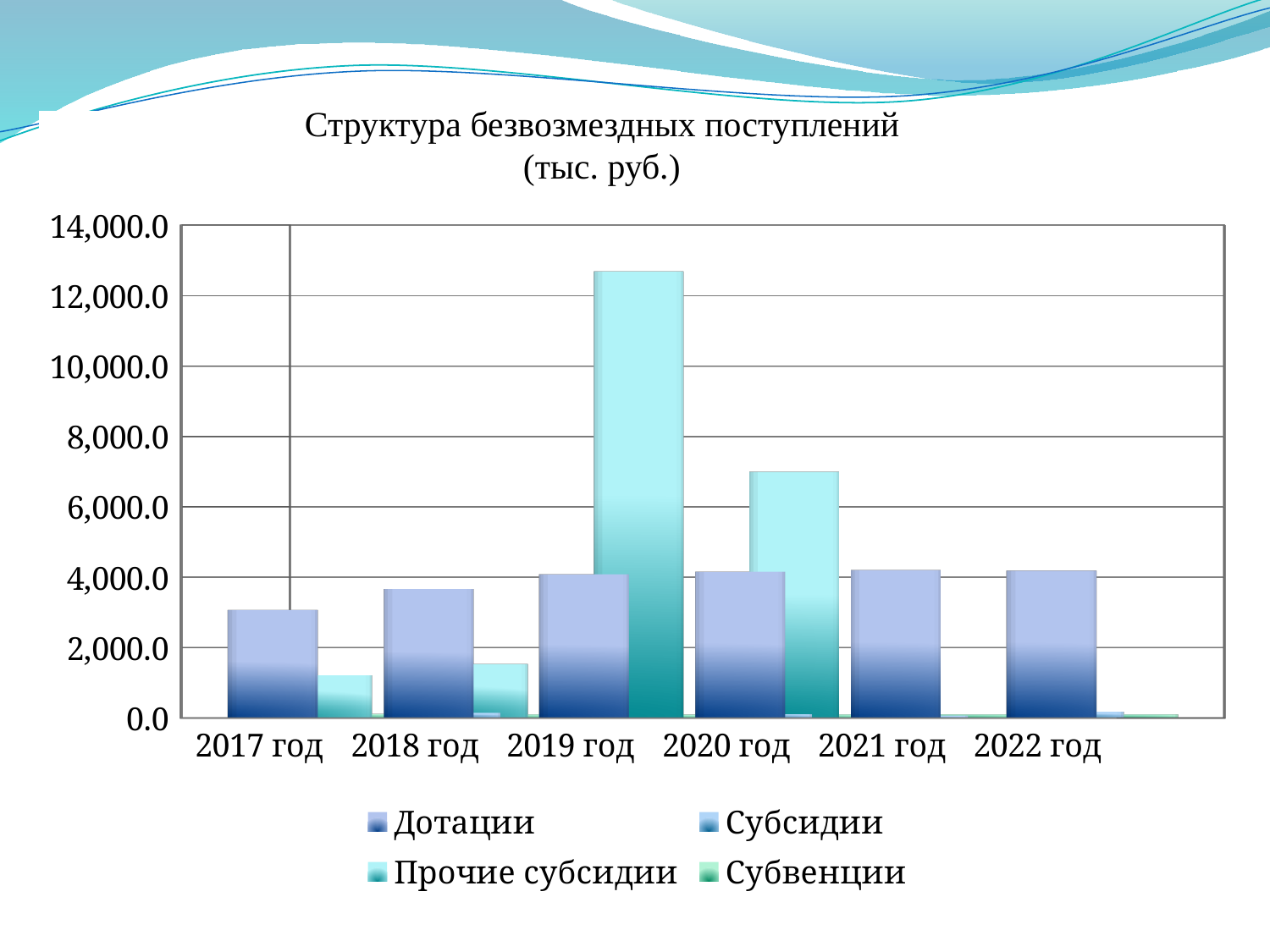
Which year has the lowest value for Дотации? 2017 год Is the value for Дотации in 2021 год greater or less than 2,000.0? greater What is the title of the chart? Структура безвозмездных поступлений (тыс. руб.) In 2018 год, which is larger: Дотации or Прочие субсидии? Дотации Is the value for Прочие субсидии in 2019 год greater or less than 12,000.0? greater How many series does the legend list? 4 How many years are shown on the x axis? 6 Is the value for Дотации in 2017 год greater or less than 4,000.0? less Do the values for Дотации rise or fall from 2017 год to 2019 год? rise In which year is the value for Прочие субсидии the highest? 2019 год What kind of chart is shown on the slide? bar chart